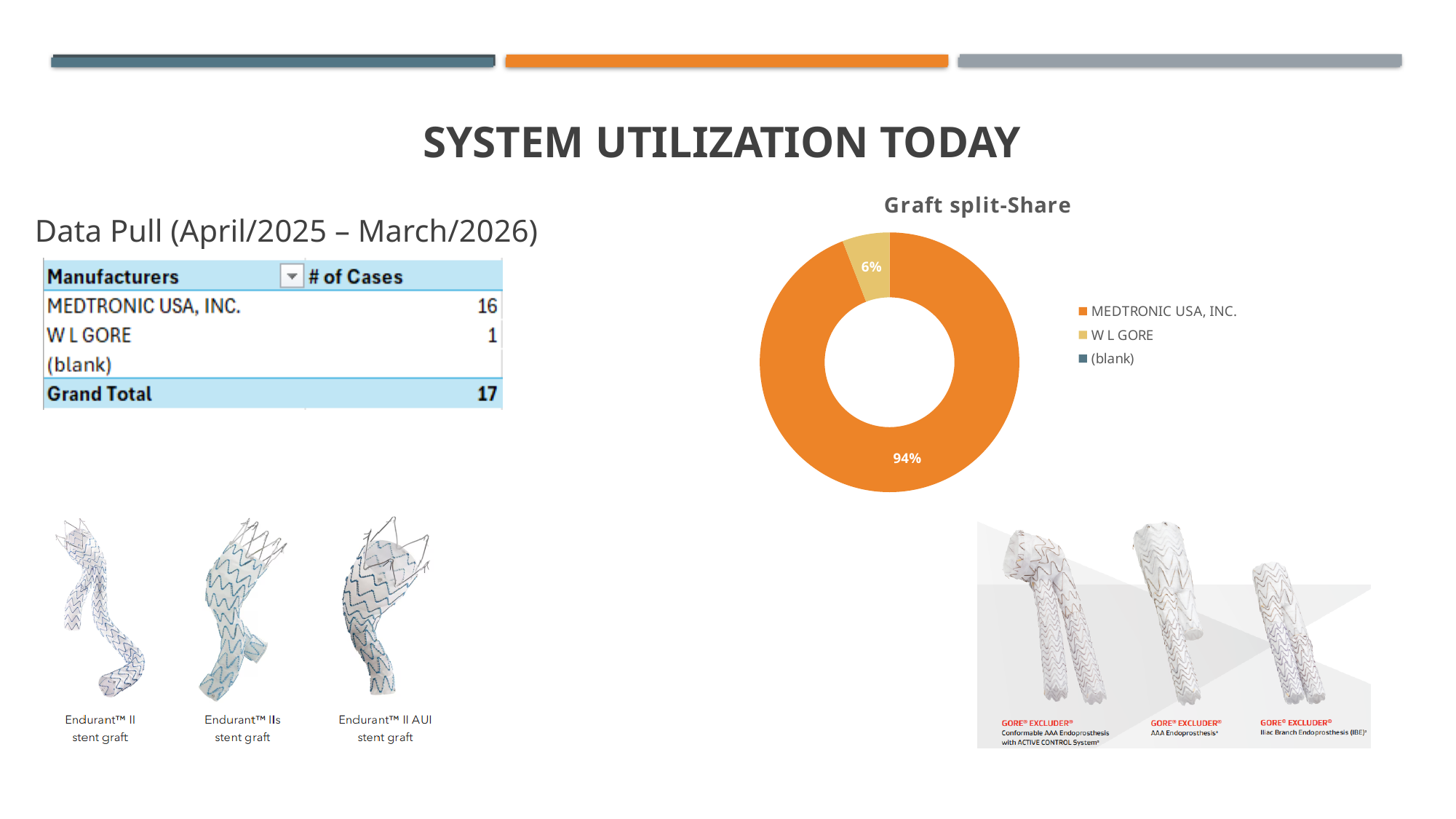
What kind of chart is shown under the title "Graft split-Share"? Pie chart (doughnut) What colour is the MEDTRONIC USA, INC. slice in the Graft split-Share chart? Orange What is the difference in percentage points between the MEDTRONIC USA, INC. slice and the W L GORE slice in the Graft split-Share chart? 88 percentage points In the Graft split-Share chart, which slice is larger: MEDTRONIC USA, INC. or W L GORE? MEDTRONIC USA, INC. In the Graft split-Share chart, what share is labelled for W L GORE? 6% Which legend entry in the Graft split-Share chart has no visible slice? (blank) In the Graft split-Share chart, what share is labelled for MEDTRONIC USA, INC.? 94% Is the share for MEDTRONIC USA, INC. in the Graft split-Share chart greater or less than 50%? greater Which manufacturer has the largest slice in the Graft split-Share chart? MEDTRONIC USA, INC. How many entries does the legend of the Graft split-Share chart list? 3 What is the title of the chart on the slide? Graft split-Share